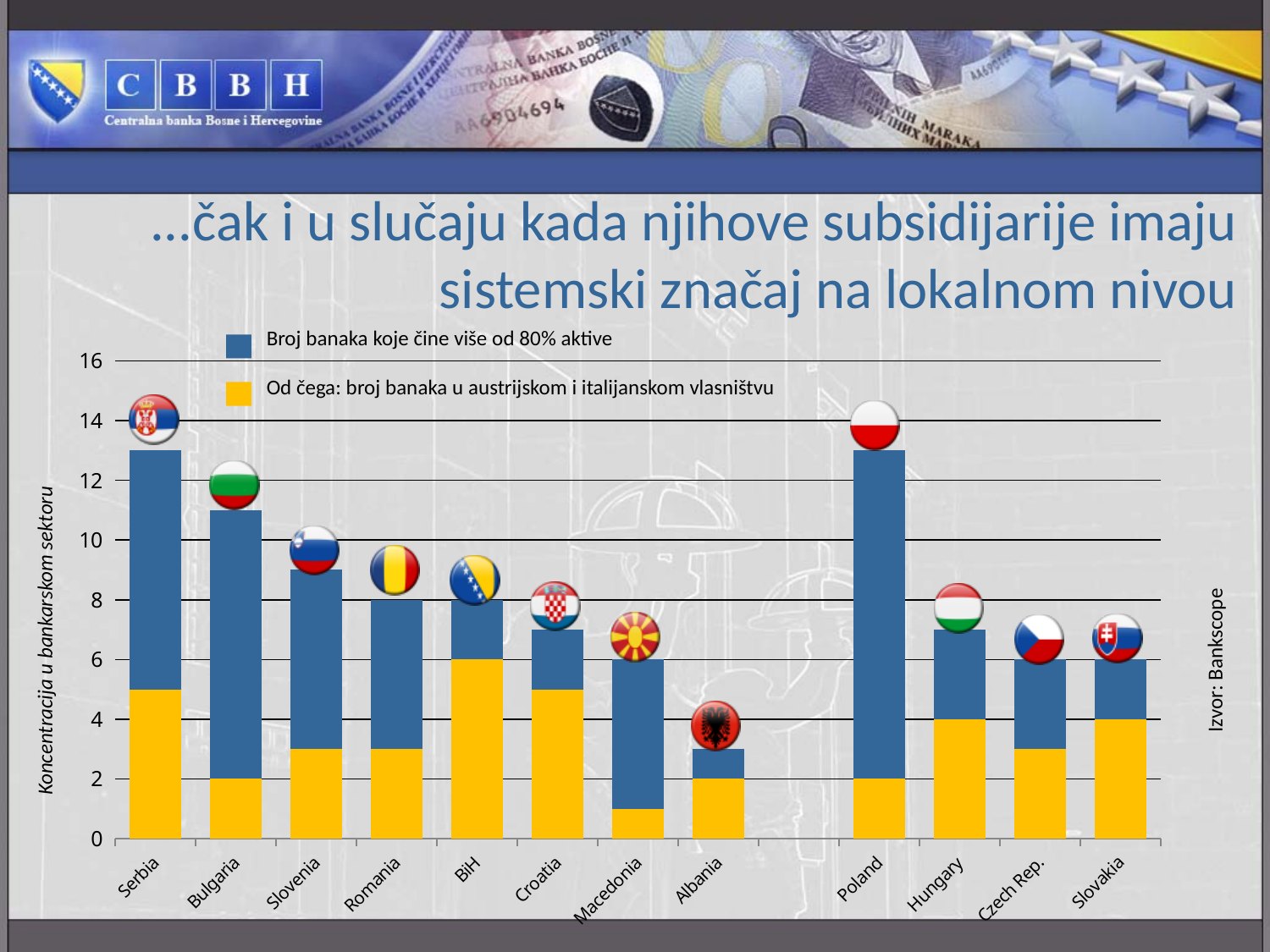
How many series does the chart legend list? 2 How many countries are shown on the x axis of the chart? 12 What is the value of 'Od čega: broj banaka u austrijskom i italijanskom vlasništvu' for Hungary? 4 Which country has the lowest value for 'Broj banaka koje čine više od 80% aktive'? Albania What type of chart is shown on the slide? bar chart What is the value of 'Broj banaka koje čine više od 80% aktive' for Slovakia? 6 For BiH, what is the difference between 'Broj banaka koje čine više od 80% aktive' and 'Od čega: broj banaka u austrijskom i italijanskom vlasništvu'? 2 What is the value of 'Od čega: broj banaka u austrijskom i italijanskom vlasništvu' for BiH? 6 Is the value of 'Broj banaka koje čine više od 80% aktive' for Serbia greater or less than 12? greater Which has the larger value for 'Broj banaka koje čine više od 80% aktive', Serbia or Bulgaria? Serbia What is the source cited for the chart? Bankscope What is the value of 'Broj banaka koje čine više od 80% aktive' for Romania? 8